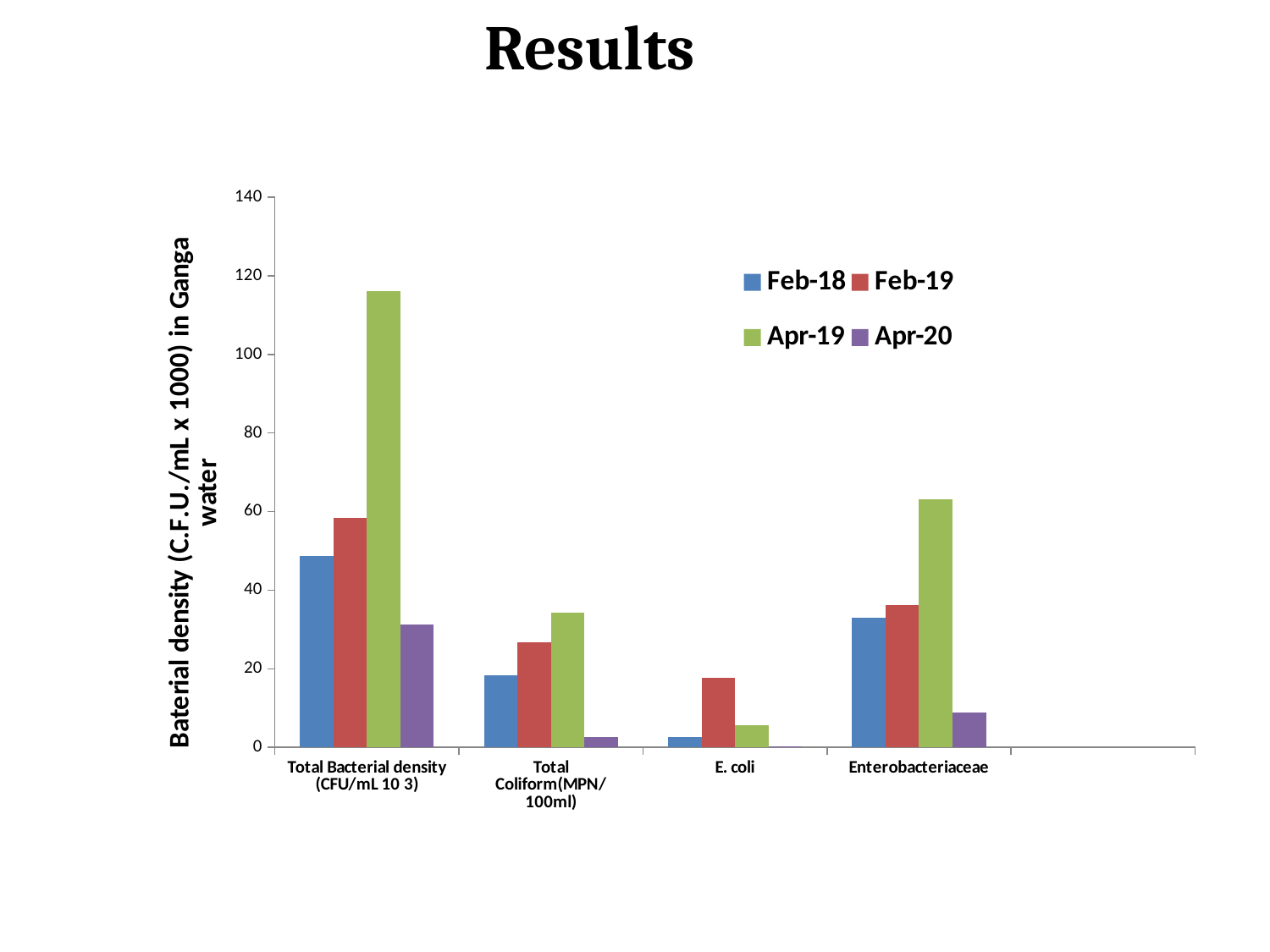
Which category has the highest Apr-19 value? Total Bacterial density (CFU/mL 10 3) Is the Feb-19 value for Total Bacterial density (CFU/mL 10 3) greater or less than 40? greater Is the Apr-19 value for Enterobacteriaceae greater or less than 40? greater Which series has the lowest value for Enterobacteriaceae? Apr-20 For E. coli, which is larger: the Feb-18 value or the Feb-19 value? Feb-19 Is the Apr-19 value for Total Bacterial density (CFU/mL 10 3) greater or less than 100? greater How many series does the legend list? 4 What kind of chart is shown on the slide? bar chart What is the title of the vertical axis? Baterial density (C.F.U./mL x 1000) in Ganga water How many categories are shown on the x axis? 4 For Total Coliform(MPN/100ml), which is larger: the Feb-19 value or the Apr-19 value? Apr-19